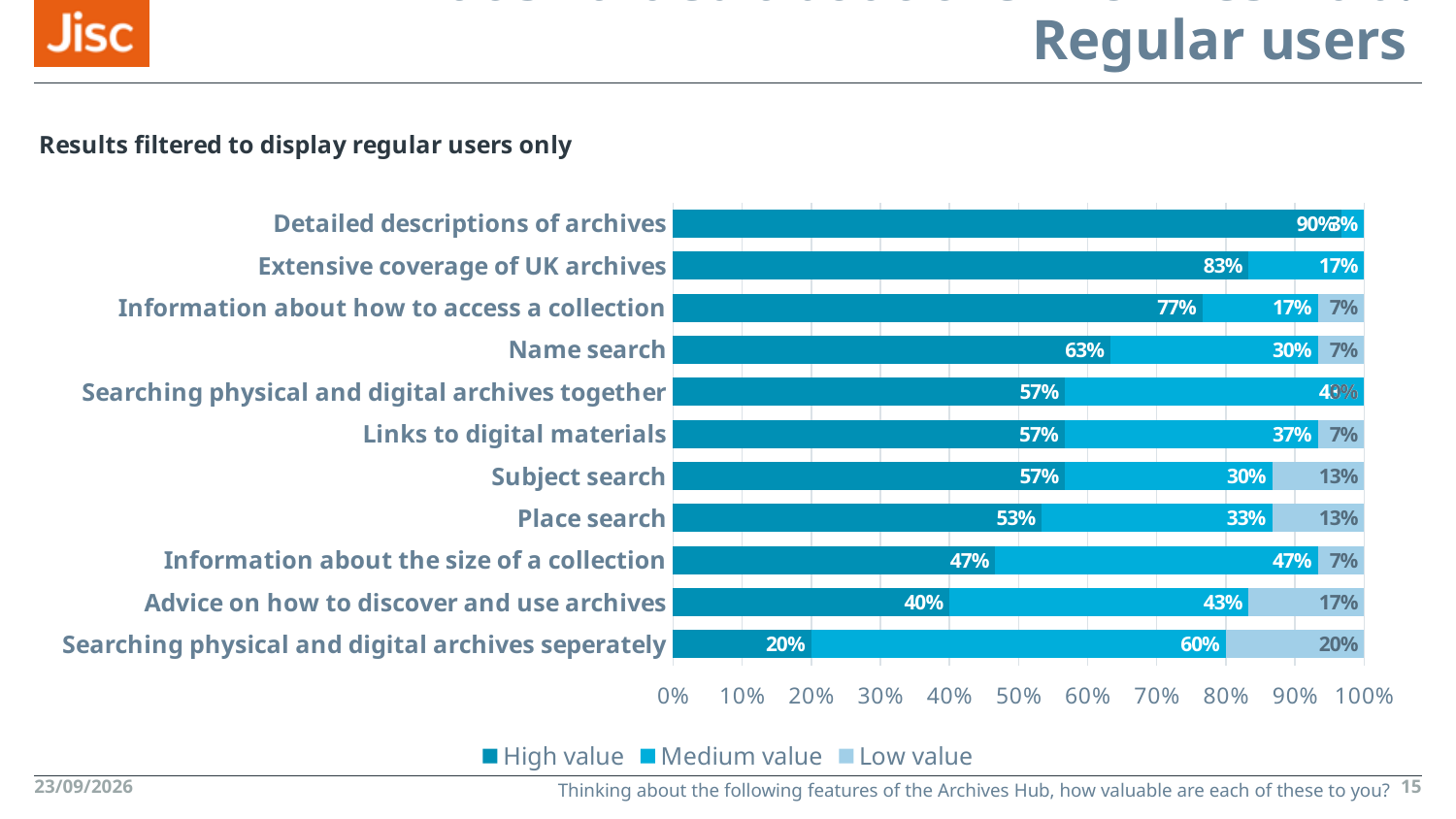
What is the High value percentage for Name search? 63% How many series does the legend list? 3 Which has a larger High value percentage: Links to digital materials or Advice on how to discover and use archives? Links to digital materials What type of chart is shown on the slide? Stacked bar chart What are the three legend entries of the chart? High value, Medium value, Low value What is the Medium value percentage for Searching physical and digital archives seperately? 60% Which feature has the highest High value percentage? Detailed descriptions of archives How many features (categories) are plotted in the chart? 11 Which feature has the lowest High value percentage? Searching physical and digital archives seperately What is the Low value percentage for Subject search? 13% What is the difference between the High value percentages for Extensive coverage of UK archives and Place search? 30% What is the total of the three segments for Name search? 100%